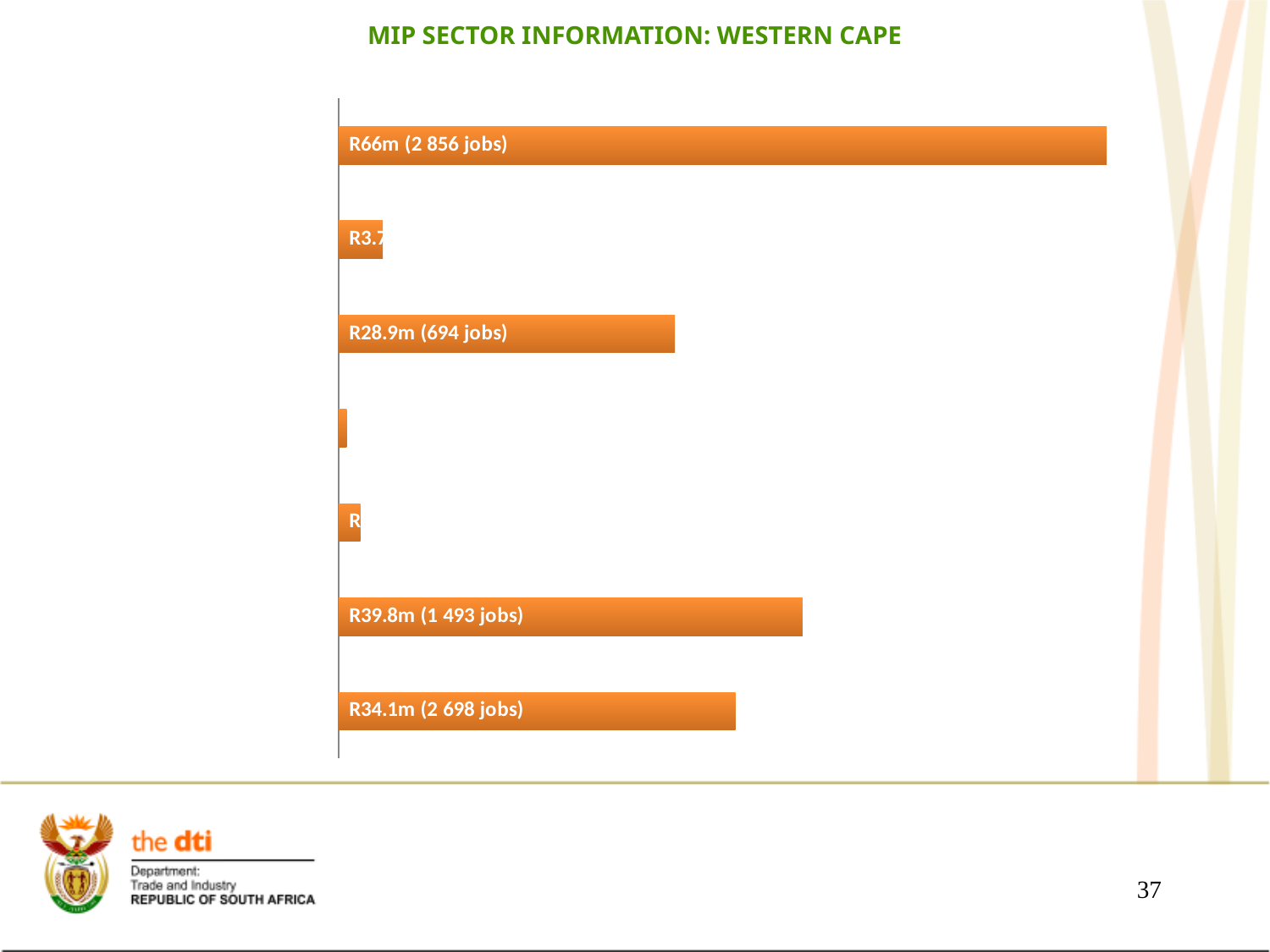
What is the title of the slide containing the chart? MIP SECTOR INFORMATION: WESTERN CAPE How many bars are plotted in the chart? 7 What is the data label on the third bar from the top? R28.9m (694 jobs) Which is larger: the value of the second bar from the bottom or the bottom bar? The second bar from the bottom (R39.8m) What is the data label on the top bar of the chart? R66m (2 856 jobs) How many jobs are shown for the bottom bar? 2 698 jobs Which bar has the largest value in the chart? The top bar (R66m) What is the data label on the second bar from the bottom? R39.8m (1 493 jobs) What is the difference in rand value between the second bar from the bottom (R39.8m) and the bottom bar (R34.1m)? R5.7m What is the data label on the bottom bar of the chart? R34.1m (2 698 jobs) What kind of chart is shown on the slide? Bar chart Which bar has the smallest value in the chart? The fourth bar from the top